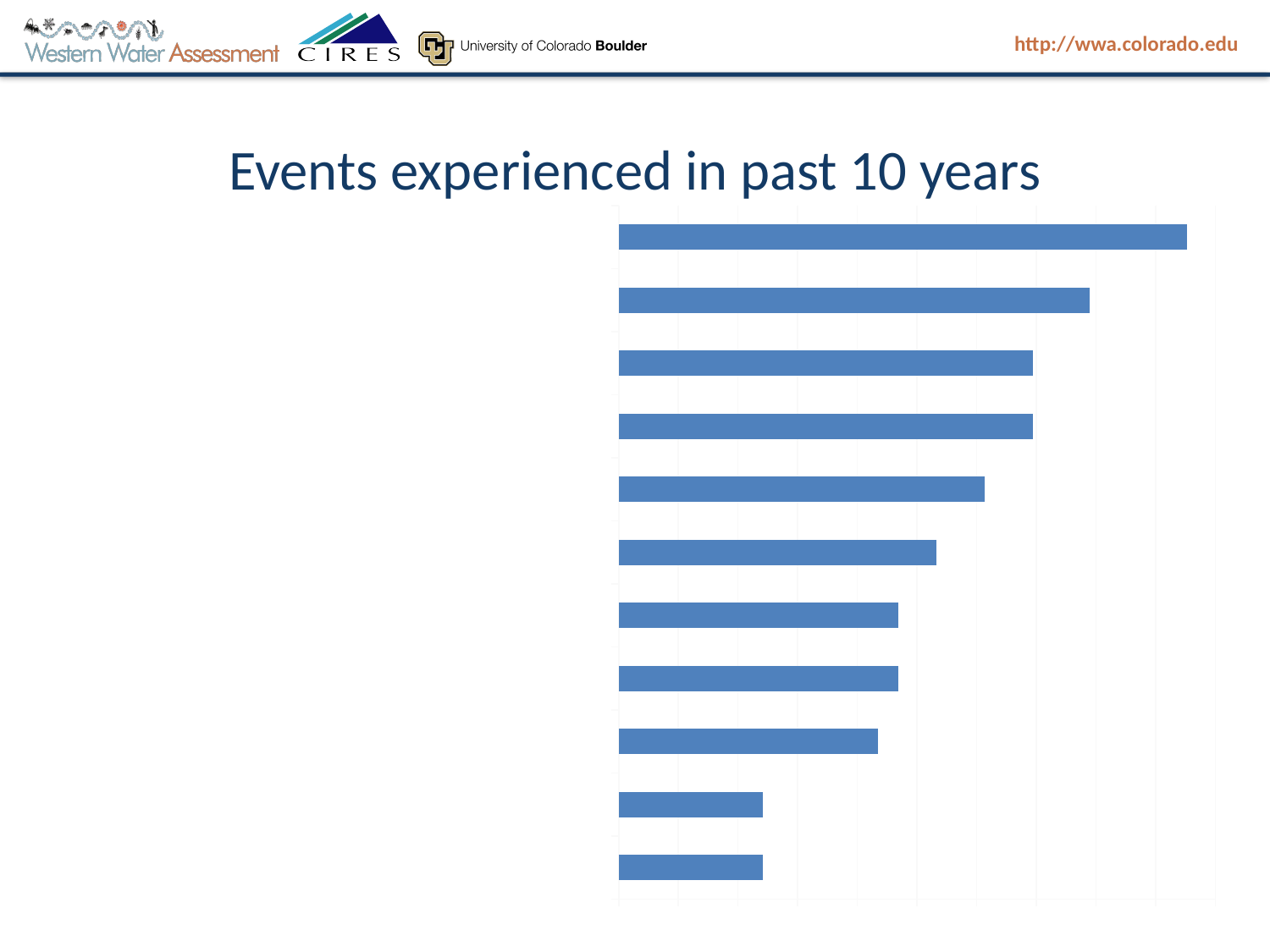
Do the bar lengths decrease or increase going from the top bar to the bottom bar? decrease How many bars does the chart contain? 11 What is the title of the chart on the slide? Events experienced in past 10 years Are the bars in the chart arranged horizontally or vertically? horizontally What kind of chart is shown on the slide? bar chart